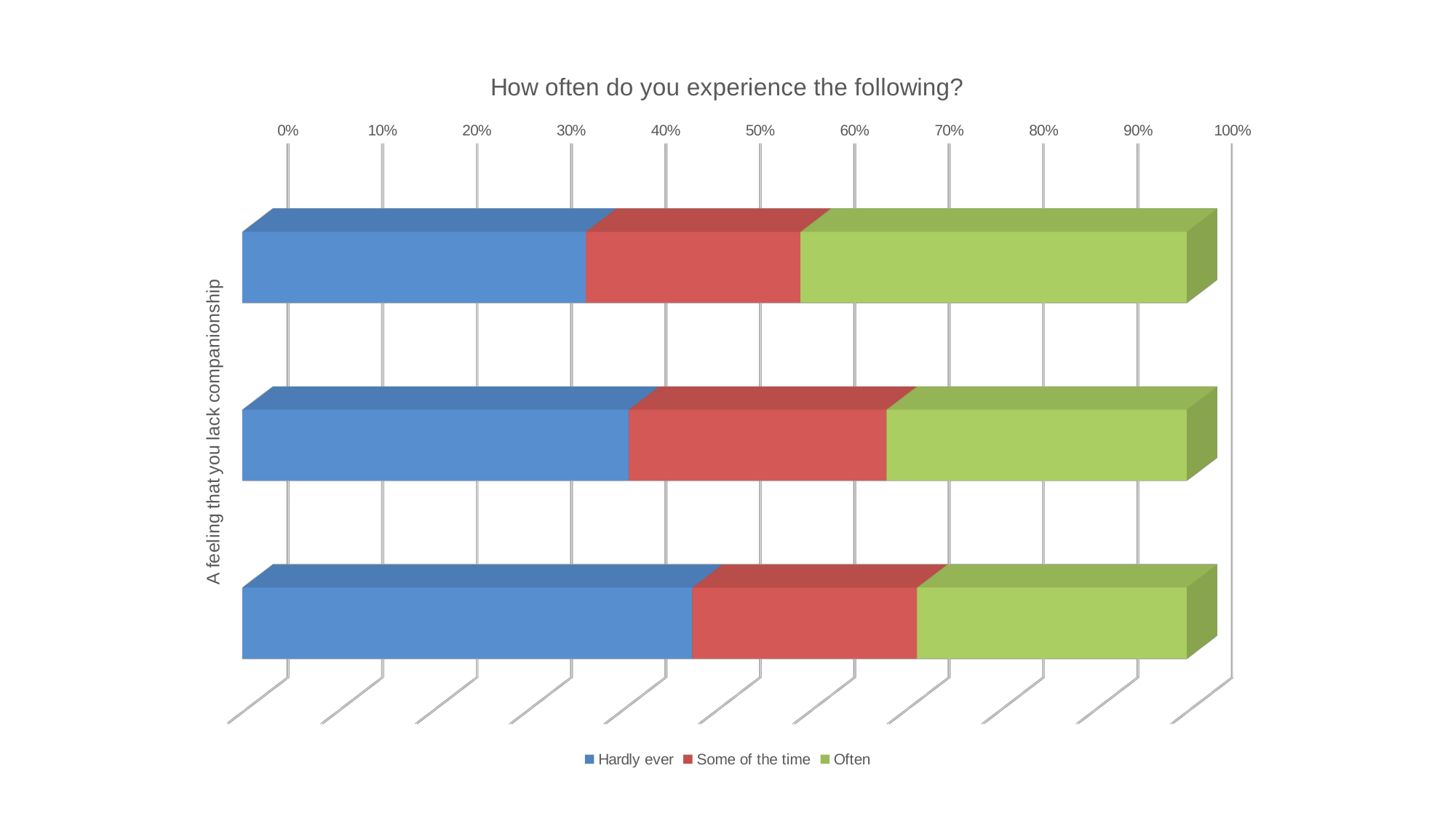
Which bar has the largest 'Often' segment? The top bar What kind of chart is shown on the slide? Stacked bar chart Is the 'Hardly ever' value for the bottom bar greater or less than 30%? greater Is the 'Hardly ever' value for the middle bar greater or less than 50%? less How many series does the legend list? 3 Which bar has the larger 'Hardly ever' segment, the top bar or the bottom bar? The bottom bar How many bars are plotted in the chart? 3 What is the title of the chart? How often do you experience the following? Which bar has the smallest 'Hardly ever' segment? The top bar Is the 'Hardly ever' value for the top bar greater or less than 40%? less Which series is shown in green in the legend? Often